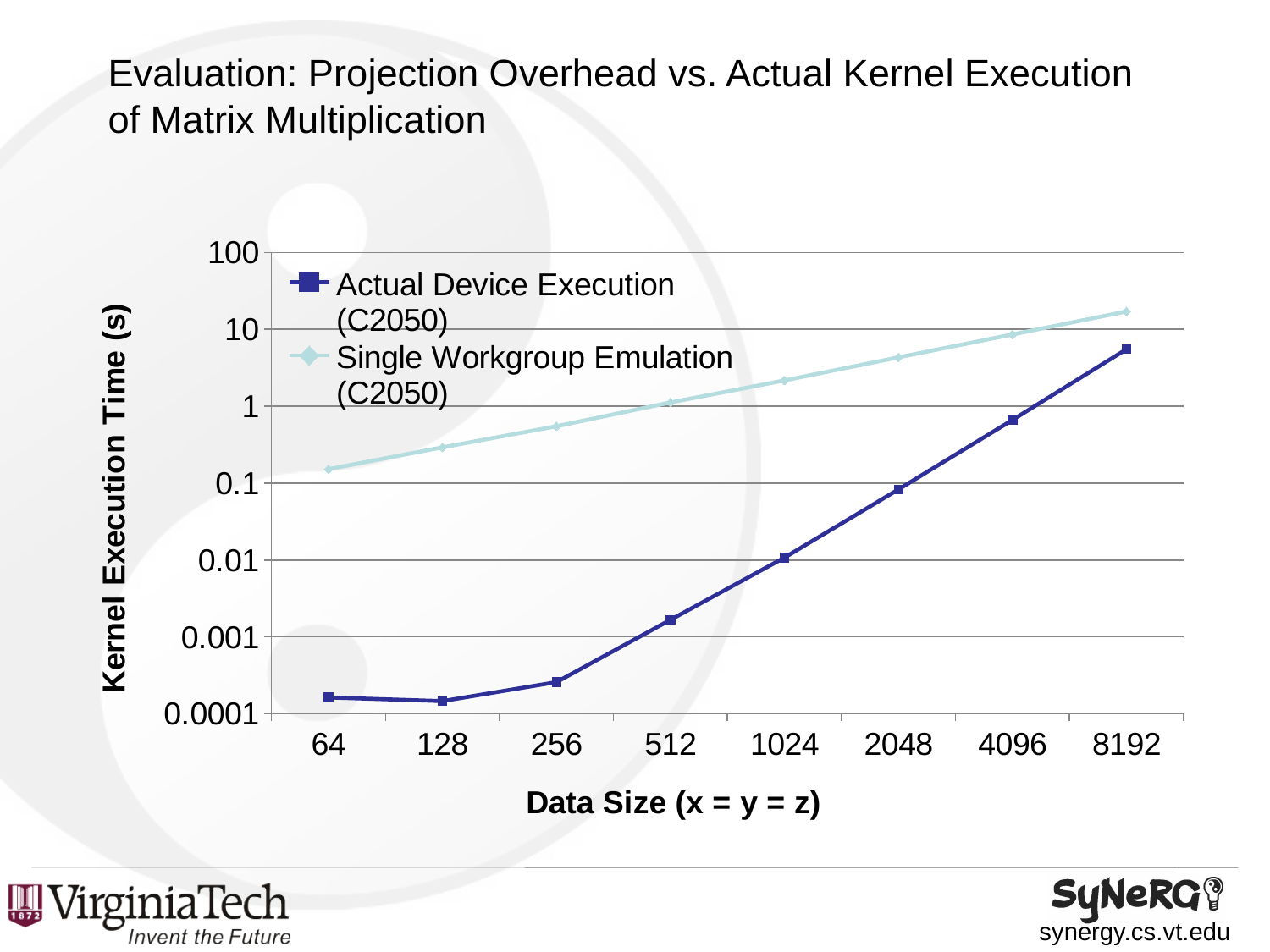
Is the value for Single Workgroup Emulation (C2050) at data size 2048 greater or less than 1? greater Does the Single Workgroup Emulation (C2050) line rise or fall as data size increases? rise At which data size does Actual Device Execution (C2050) reach its highest kernel execution time? 8192 How many data sizes are plotted along the x axis? 8 Is the value for Single Workgroup Emulation (C2050) at data size 8192 greater or less than 10? greater At data size 64, which series has the larger kernel execution time? Single Workgroup Emulation (C2050) Is the value for Single Workgroup Emulation (C2050) at data size 64 greater or less than 0.1? greater How many series does the legend list? 2 What is the label of the y axis? Kernel Execution Time (s) What kind of chart is shown on the slide? line chart